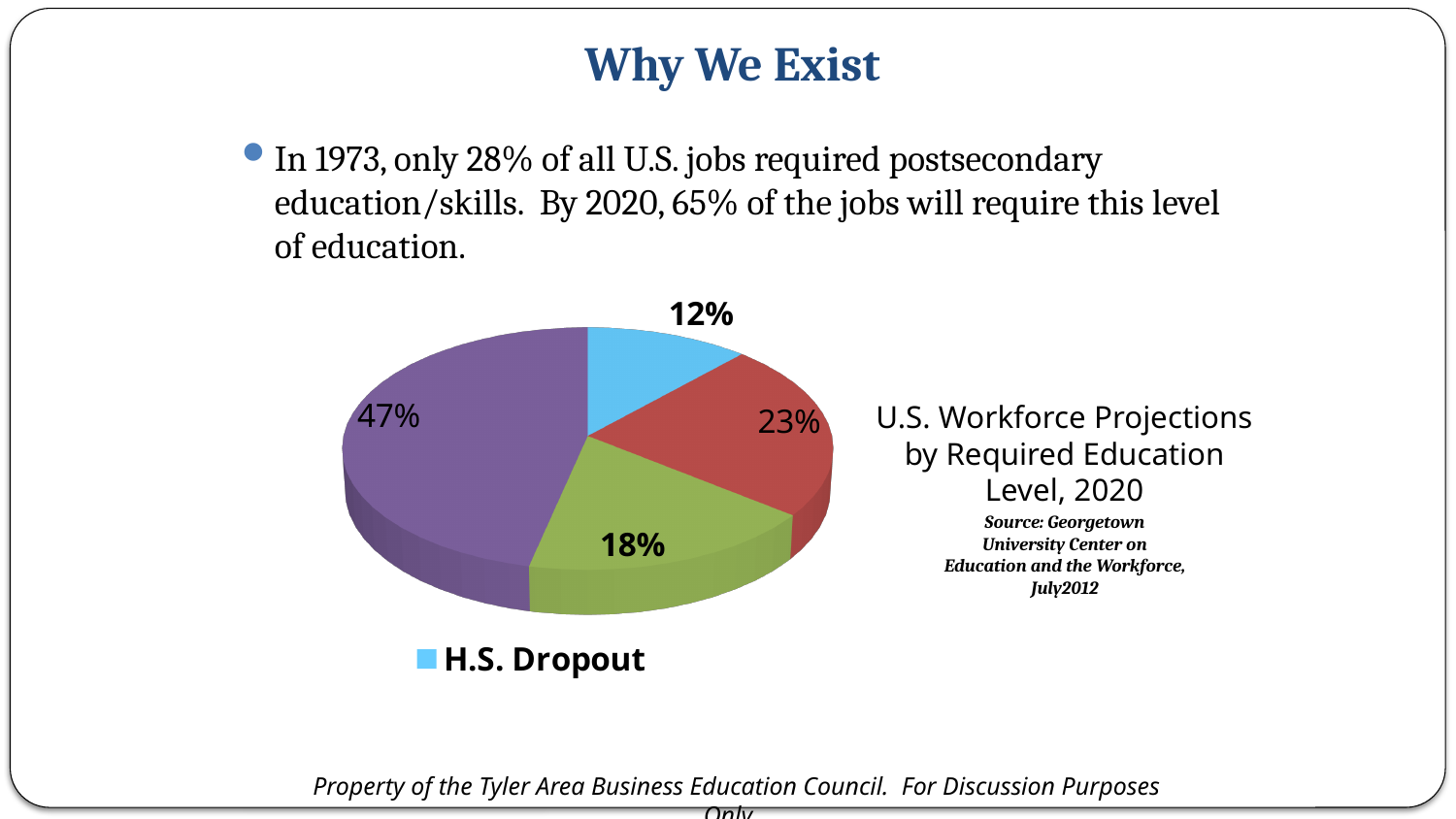
What is the title of the pie chart? U.S. Workforce Projections by Required Education Level, 2020 What colour is the H.S. Dropout slice in the pie chart? Light blue What is the total of all the slice percentages shown in the pie chart? 100% What share of the pie does the purple slice represent? 47% What kind of chart is shown on the slide? Pie chart What is the value of the smallest slice in the pie chart? 12% Is the H.S. Dropout slice larger or smaller than the red slice? Smaller What is the difference between the largest slice (47%) and the H.S. Dropout slice? 35% What is the difference between the red slice (23%) and the green slice (18%)? 5% How many slices does the pie chart have? 4 What is the value of the largest slice in the pie chart? 47% What percentage of the pie chart is labelled H.S. Dropout? 12%